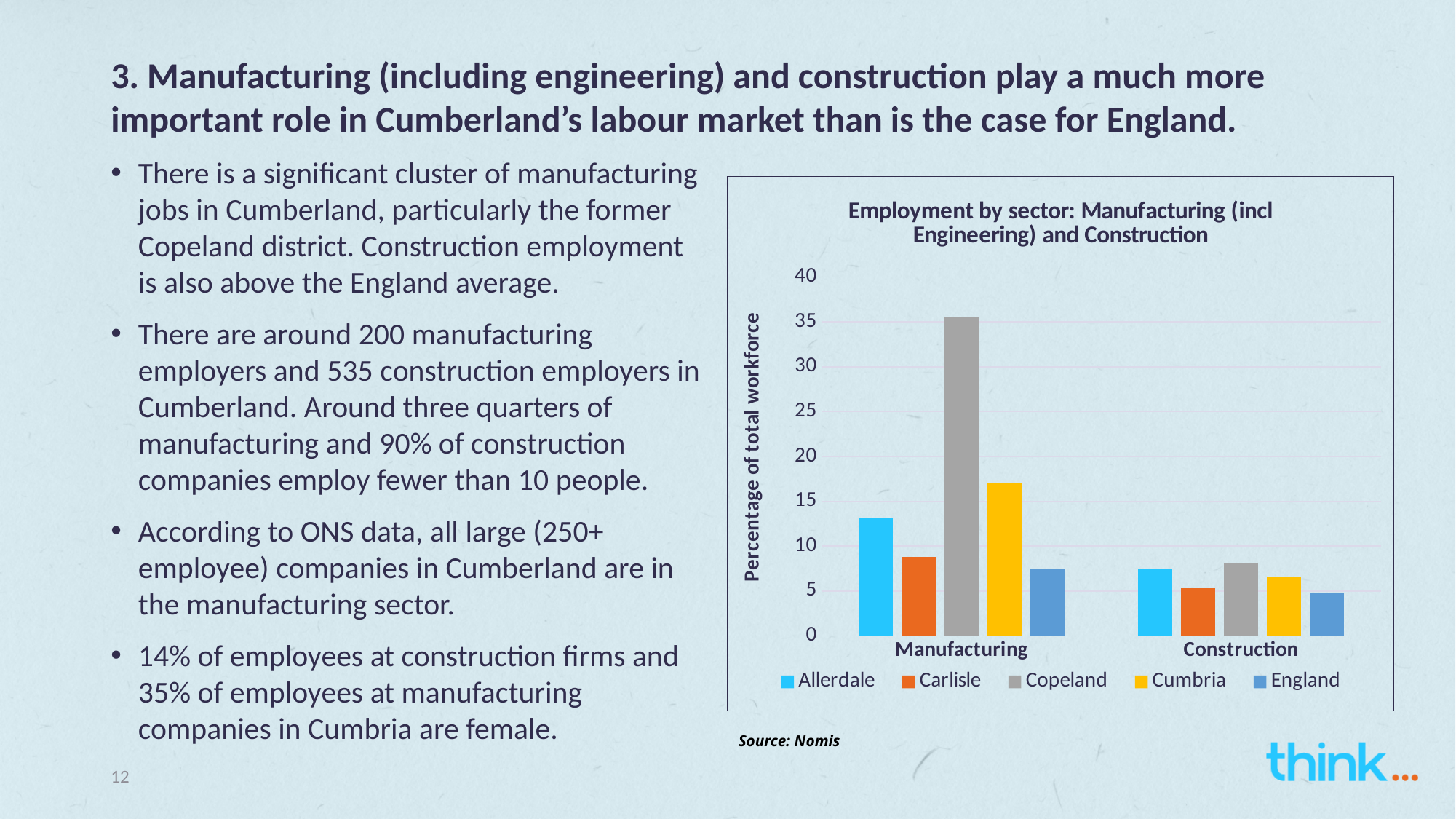
What is the title of the chart? Employment by sector: Manufacturing (incl Engineering) and Construction Is the Construction value for Carlisle greater or less than 10? less How many series does the chart legend list? 5 Is the Manufacturing value for Carlisle greater or less than 10? less Which area has the highest value for Manufacturing? Copeland Which is larger for Copeland: the Manufacturing value or the Construction value? Manufacturing What is the label on the vertical axis of the chart? Percentage of total workforce Is the Manufacturing value for Copeland greater or less than 30? greater How many sector categories are shown on the x axis of the chart? 2 Which is larger for Manufacturing: Cumbria or Allerdale? Cumbria What kind of chart is shown on the slide? bar chart